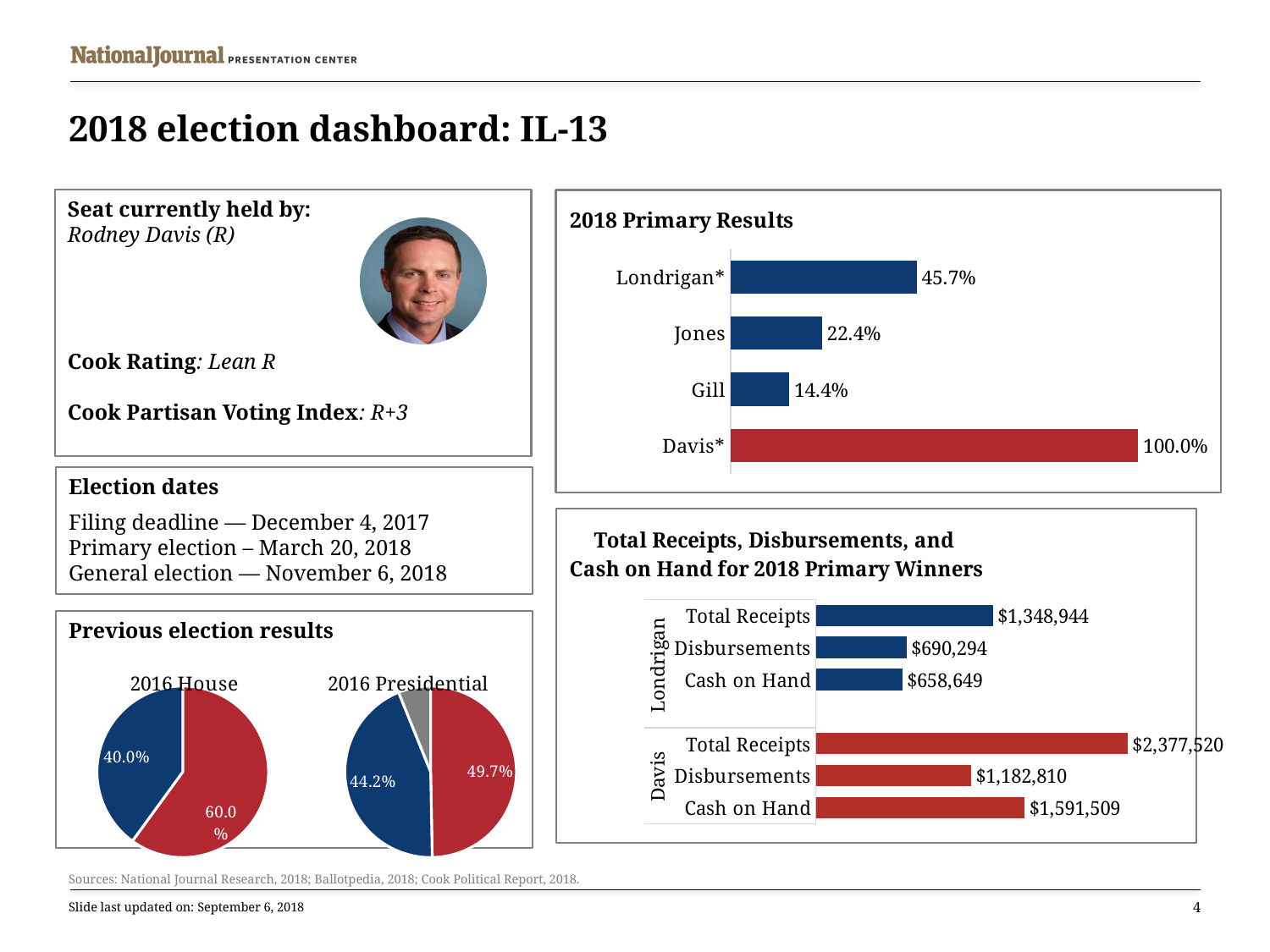
In the 2018 Primary Results chart, what is the difference between Londrigan*'s and Jones's percentages? 23.3% In the Total Receipts, Disbursements, and Cash on Hand chart, what are Londrigan's Total Receipts? $1,348,944 In the Total Receipts, Disbursements, and Cash on Hand chart, what is the difference between Davis's and Londrigan's Total Receipts? $1,028,576 What kind of chart is the 2018 Primary Results chart? Bar chart In the Total Receipts, Disbursements, and Cash on Hand chart, what is Davis's Cash on Hand? $1,591,509 In the 2016 Presidential pie chart, what percentage is shown for the blue slice? 44.2% In the Total Receipts, Disbursements, and Cash on Hand chart, which is larger: Londrigan's Disbursements or Davis's Disbursements? Davis's Disbursements In the 2016 House pie chart, what share does the red slice represent? 60.0% In the 2018 Primary Results chart, how many candidates are shown? 4 In the 2018 Primary Results chart, what percentage did Jones receive? 22.4% In the 2018 Primary Results chart, which candidate has the lowest percentage? Gill In the 2018 Primary Results chart, what percentage did Gill receive? 14.4%